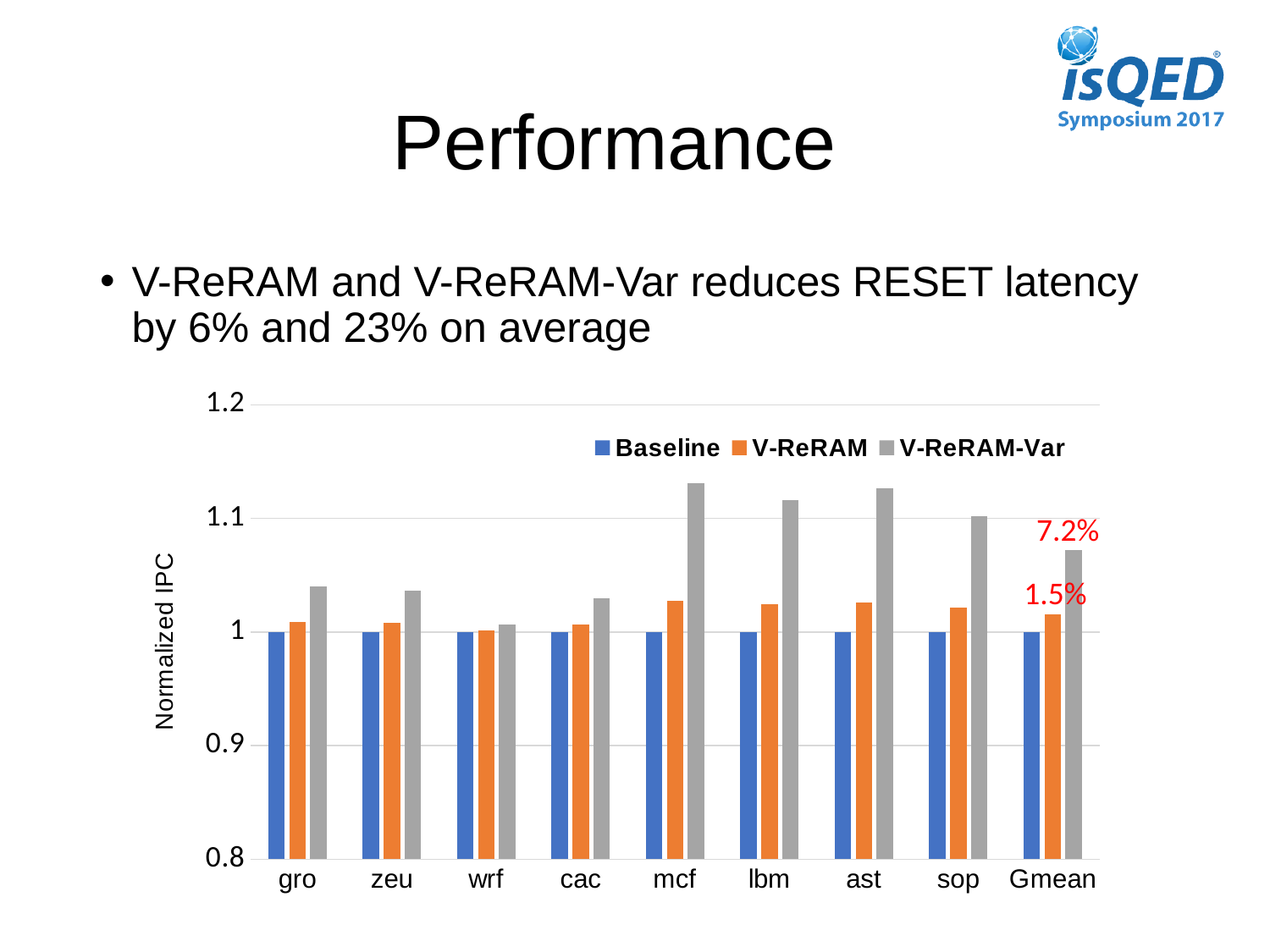
Which category has the lowest V-ReRAM-Var value? wrf What kind of chart is shown on the slide? bar chart How many categories are shown along the x axis? 9 Is the V-ReRAM value for mcf greater or less than 1.1? less What is the Baseline value for gro? 1 What percentage label is printed above the V-ReRAM-Var bar for Gmean? 7.2% Which is larger, the V-ReRAM-Var value for mcf or for wrf? mcf What is the label of the y axis? Normalized IPC Is the V-ReRAM-Var value for gro greater or less than 1.1? less What percentage label is printed above the V-ReRAM bar for Gmean? 1.5% How many series does the legend list? 3 Is the V-ReRAM-Var value for mcf greater or less than 1.1? greater